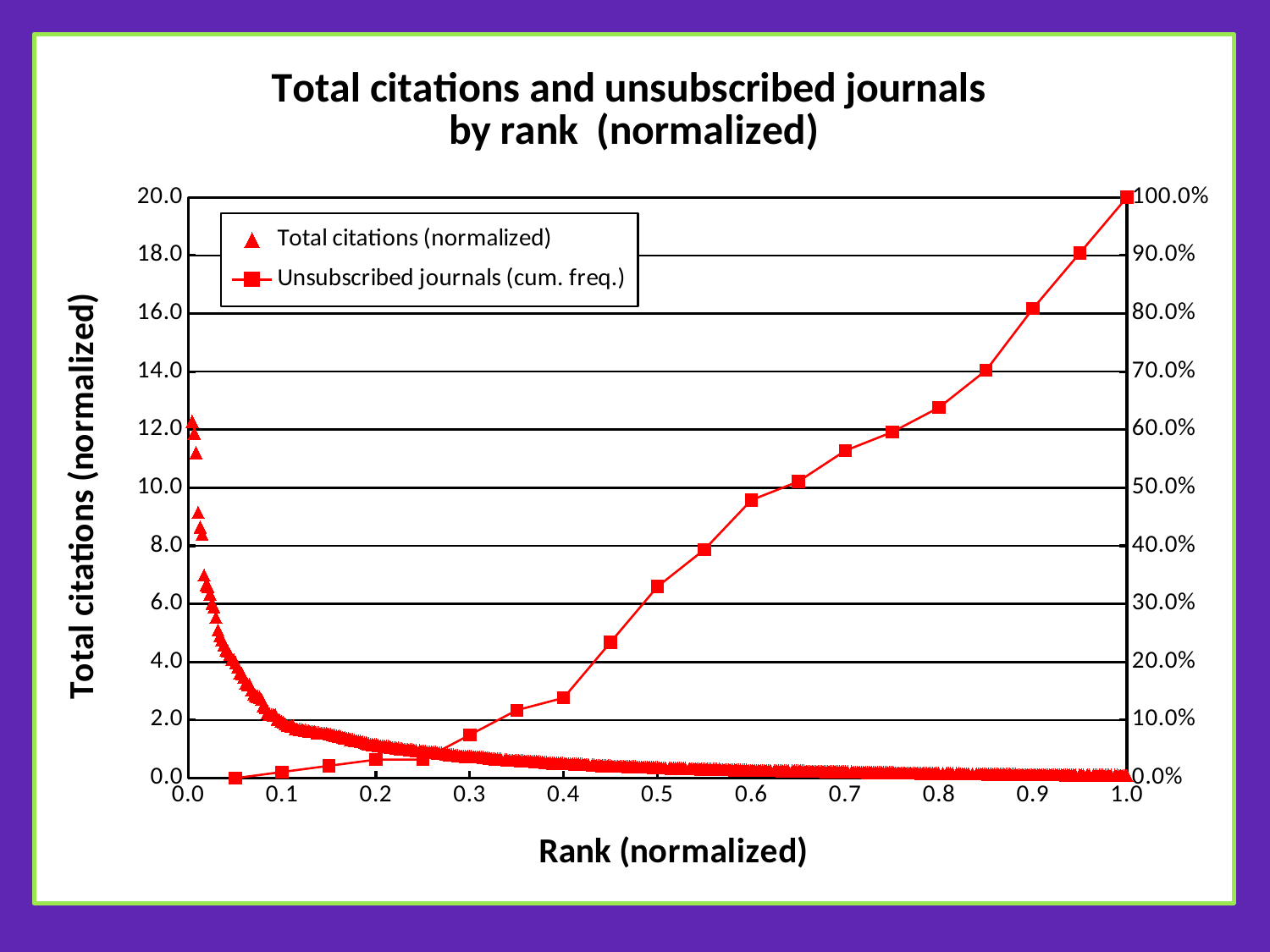
At which rank does the Unsubscribed journals (cum. freq.) series reach its highest value? 1.0 Is the highest Total citations (normalized) value greater or less than 10.0? greater What is the title of the chart? Total citations and unsubscribed journals by rank (normalized) Which is larger for Unsubscribed journals (cum. freq.): the value at rank 0.6 or at rank 0.8? rank 0.8 What is the value of Unsubscribed journals (cum. freq.) at rank 1.0? 100.0% What is the value of Unsubscribed journals (cum. freq.) at rank 0.05? 0.0% What is the label of the x axis? Rank (normalized) Does the Total citations (normalized) series rise or fall as rank increases? fall Is the value of Unsubscribed journals (cum. freq.) at rank 0.3 greater or less than 10.0%? less How many series does the legend list? 2 Is the value of Unsubscribed journals (cum. freq.) at rank 0.6 greater or less than 50.0%? less Does the Unsubscribed journals (cum. freq.) series rise or fall as rank increases? rise